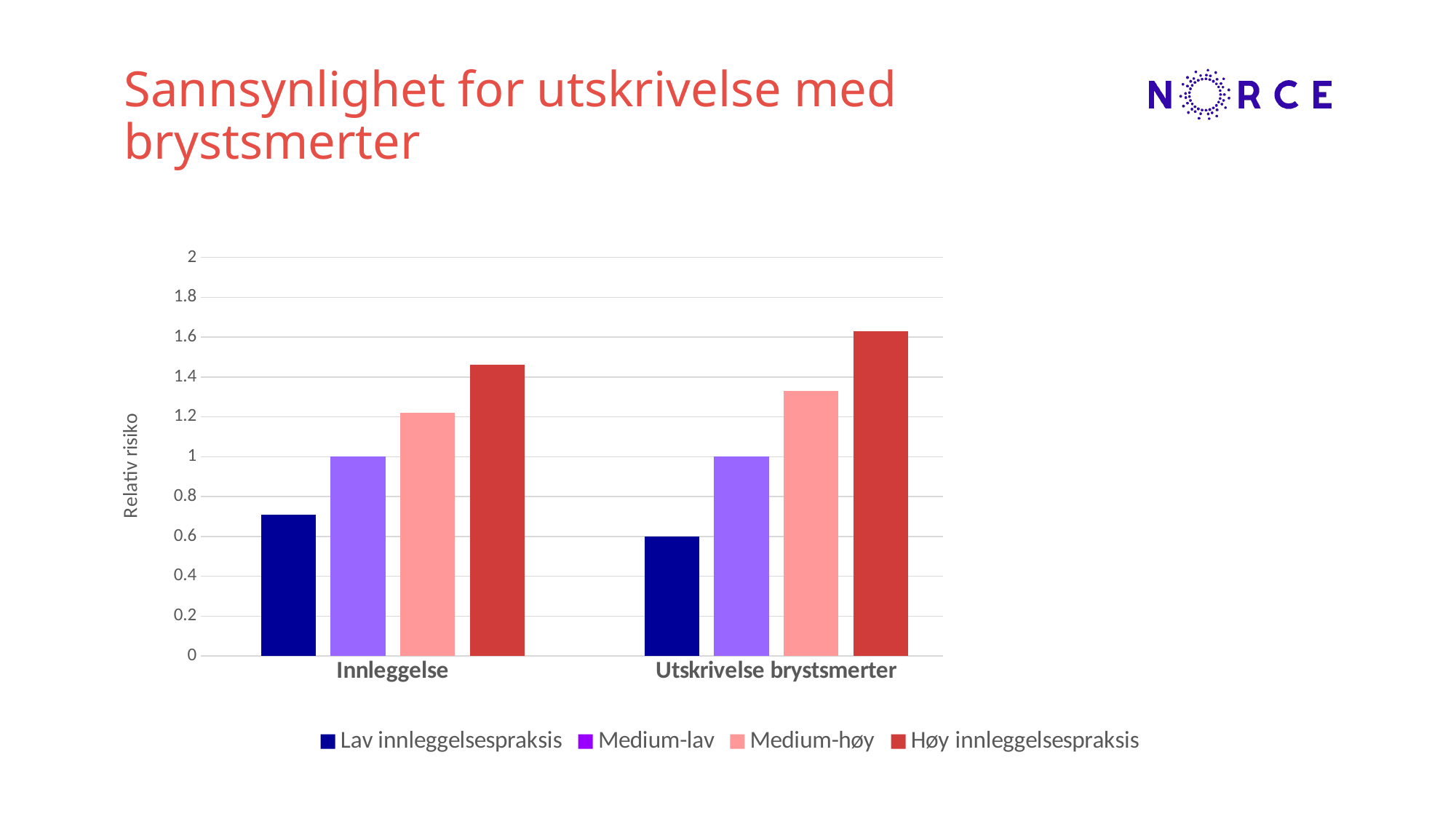
Is the value for Lav innleggelsespraksis in the Innleggelse category greater or less than 0.8? less Which series has the lowest value in the Innleggelse category? Lav innleggelsespraksis What kind of chart is shown on the slide? bar chart What is the label on the vertical axis? Relativ risiko How many series does the legend list? 4 What is the value for Medium-lav in the Utskrivelse brystsmerter category? 1 What is the value for Medium-lav in the Innleggelse category? 1 Is the value for Høy innleggelsespraksis in the Innleggelse category greater or less than 1.4? greater Is the value for Medium-høy in the Utskrivelse brystsmerter category greater or less than 1.2? greater How many categories are shown on the x axis? 2 Which series has the highest value in the Utskrivelse brystsmerter category? Høy innleggelsespraksis Which is larger: the Høy innleggelsespraksis value for Innleggelse or for Utskrivelse brystsmerter? Utskrivelse brystsmerter